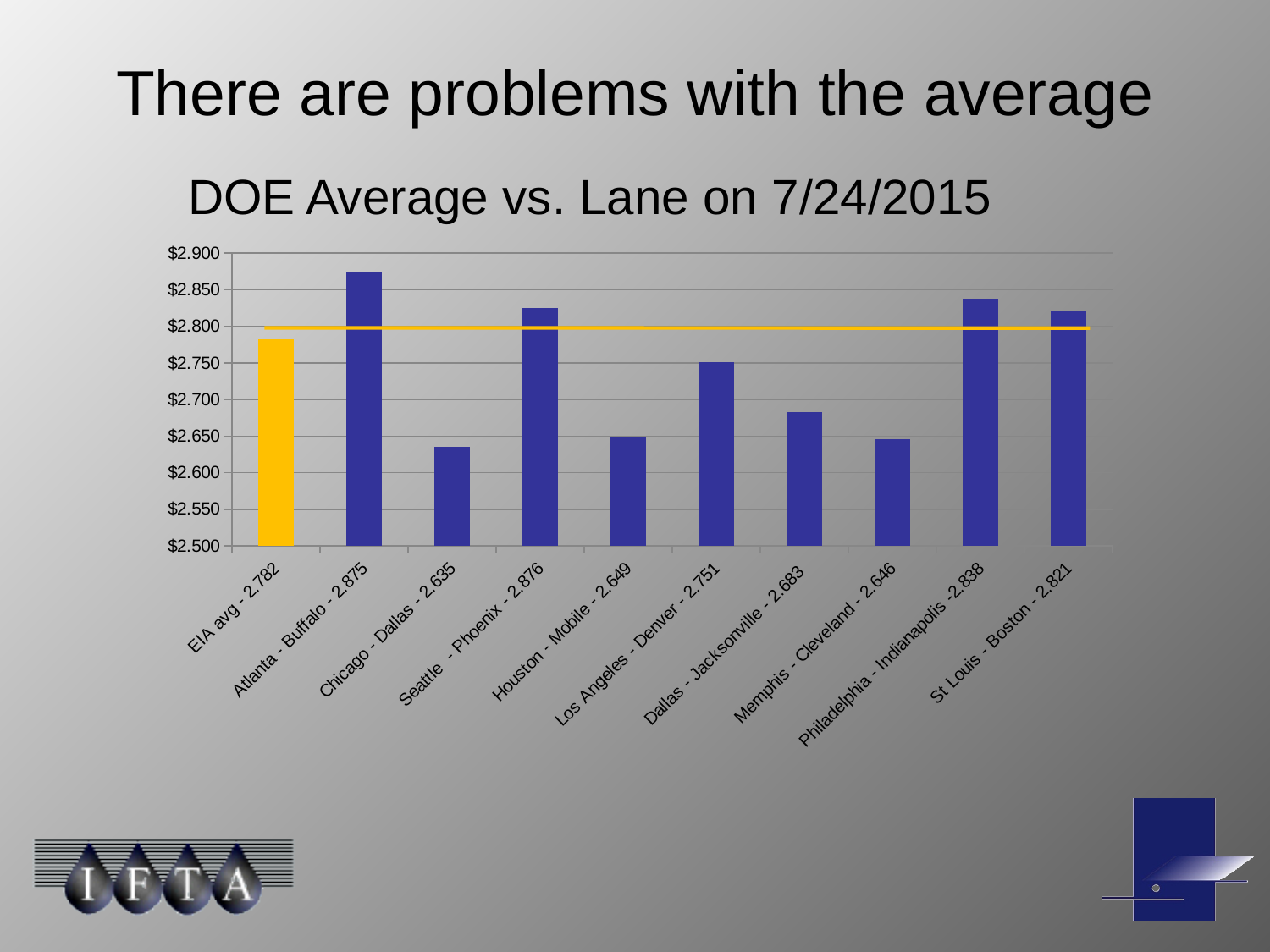
What kind of chart is shown on the slide? bar chart What is the difference between the Atlanta - Buffalo value and the EIA avg value? 0.093 Is the value for Chicago - Dallas greater or less than $2.650? less How many bars are shown on the chart? 10 What is the value shown for Philadelphia - Indianapolis? 2.838 What is the value shown for Atlanta - Buffalo? 2.875 Is the value for Seattle - Phoenix greater or less than $2.800? greater Which bar is shown in a different colour (yellow) from the others? EIA avg - 2.782 What is the value shown for the EIA avg bar? 2.782 Which is larger, the value for Philadelphia - Indianapolis or the value for St Louis - Boston? Philadelphia - Indianapolis What is the value shown for Houston - Mobile? 2.649 Which lane has the lowest value on the chart? Chicago - Dallas